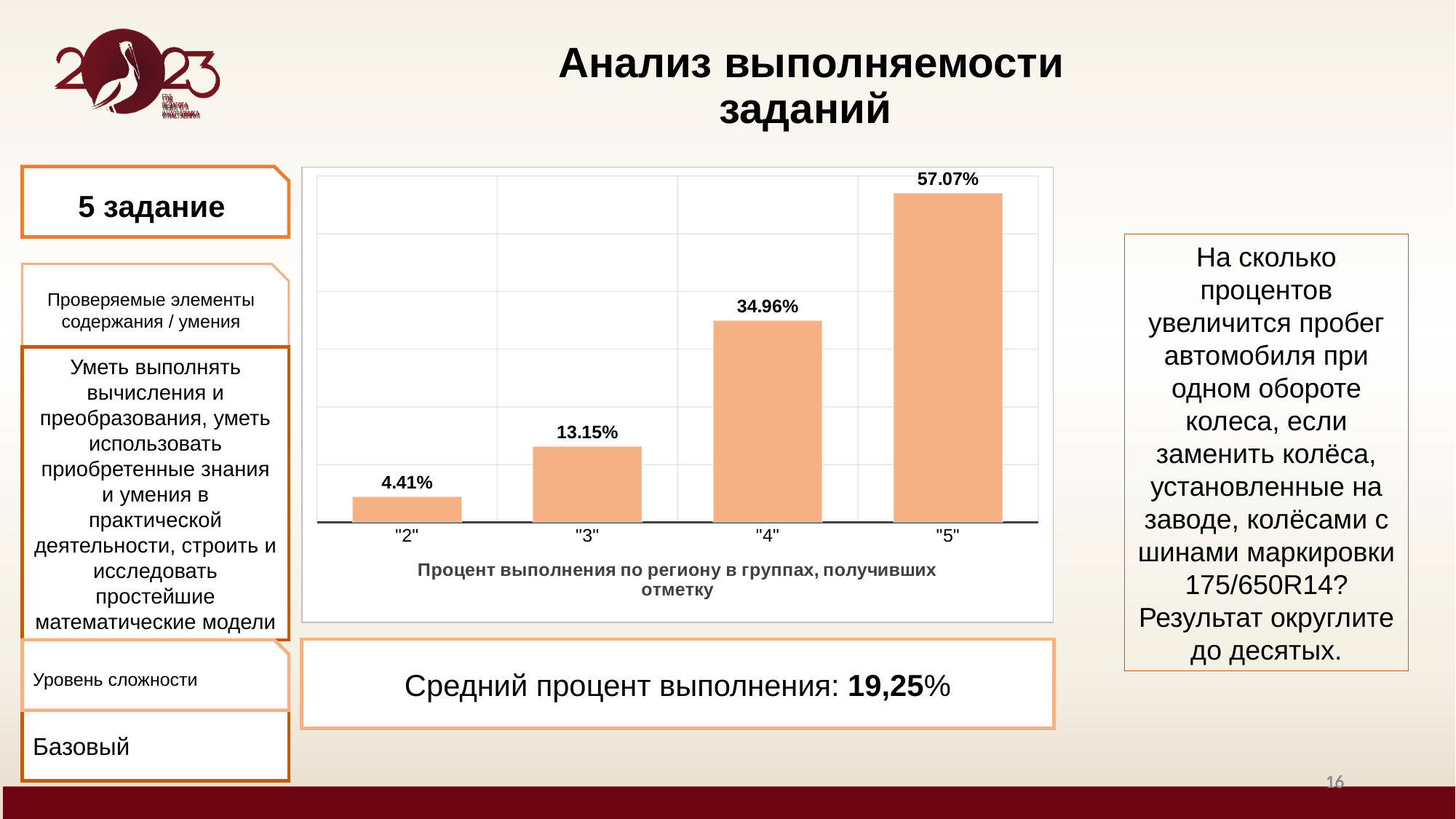
Which mark group has the highest completion percentage? "5" What type of chart is shown on the slide? Bar chart Which group has a higher completion percentage, "3" or "4"? "4" Which mark group has the lowest completion percentage? "2" How many mark groups are shown on the chart? 4 What is the completion percentage for the group that received mark "2"? 4.41% What is the completion percentage for the group that received mark "4"? 34.96% What is the completion percentage for the group that received mark "3"? 13.15% What is the difference in completion percentage between the "3" group and the "2" group? 8.74% What is the completion percentage for the group that received mark "5"? 57.07% What is the difference in completion percentage between the "5" group and the "4" group? 22.11% Do the completion percentages rise or fall as the mark increases from "2" to "5"? Rise